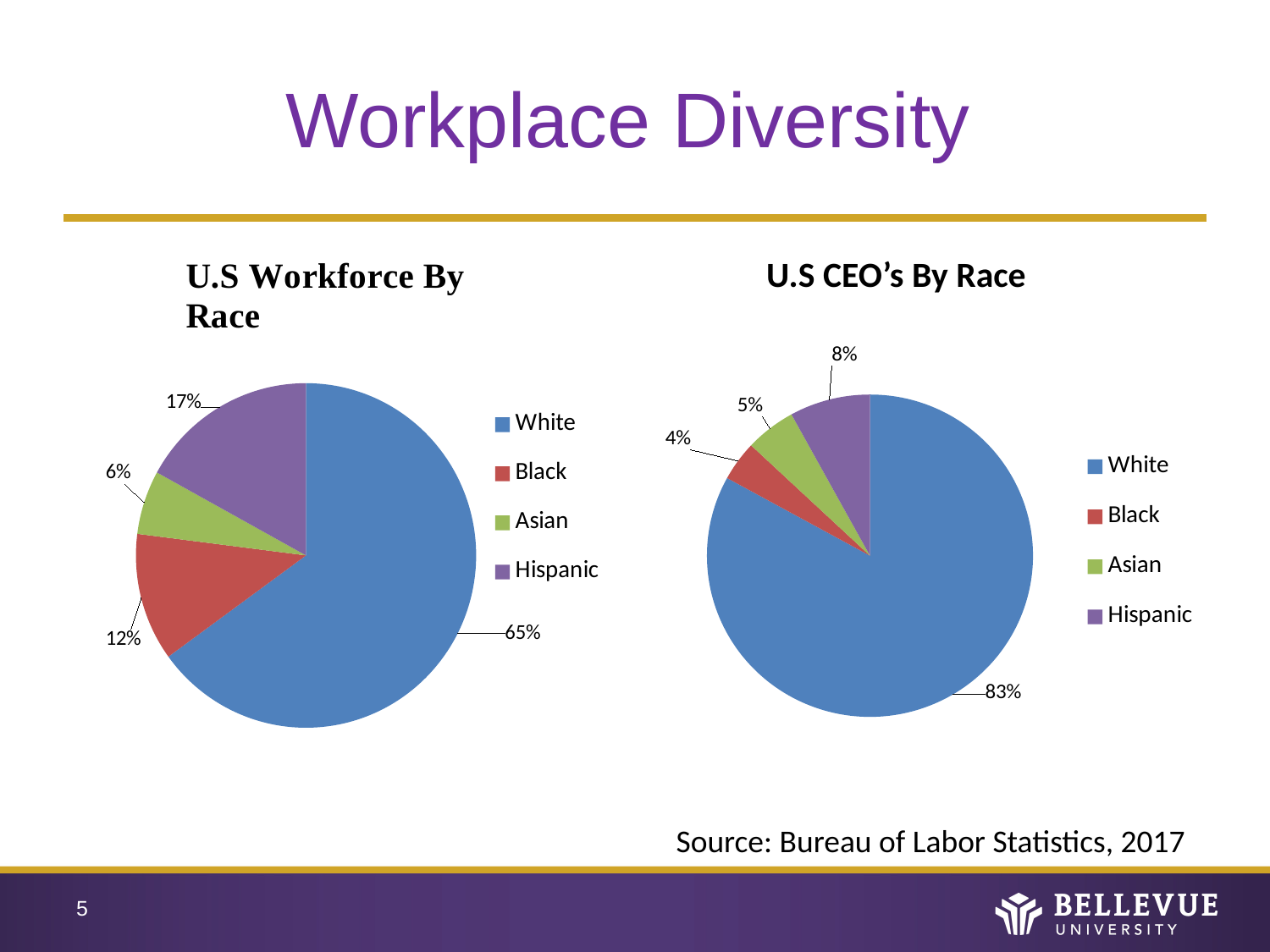
In the 'U.S Workforce By Race' chart, which race has the smallest share? Asian In the 'U.S CEO's By Race' chart, which is larger, the Hispanic share or the Asian share? Hispanic In the 'U.S Workforce By Race' chart, what is the difference between the Black share and the Asian share? 6% In the 'U.S CEO's By Race' chart, what percentage is shown for White? 83% How many categories does the 'U.S Workforce By Race' chart show? 4 What type of chart is the 'U.S CEO's By Race' chart? Pie chart In the 'U.S Workforce By Race' chart, what colour represents Hispanic? Purple In the 'U.S Workforce By Race' chart, what percentage is shown for Hispanic? 17% In the 'U.S CEO's By Race' chart, which race has the largest share? White What is the difference between the White share in the 'U.S CEO's By Race' chart and the White share in the 'U.S Workforce By Race' chart? 18% In the 'U.S Workforce By Race' chart, what percentage is shown for White? 65% In the 'U.S CEO's By Race' chart, what percentage is shown for Black? 4%